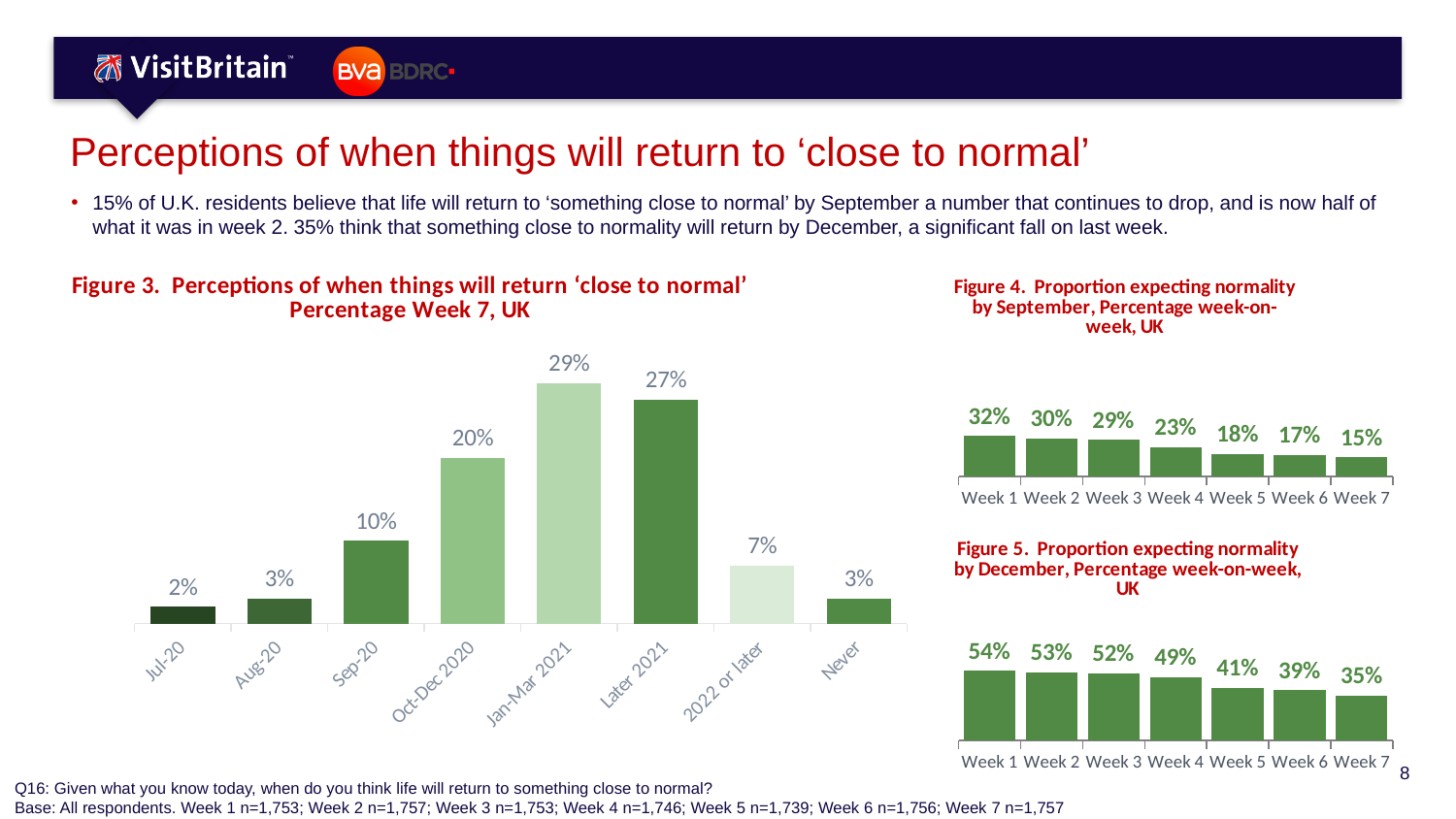
In Figure 3, what is the value for 'Never'? 3% In Figure 4, what is the value for Week 7? 15% In Figure 3, what percentage of respondents expect things to return close to normal in Jan-Mar 2021? 29% In Figure 5, what is the value for Week 4? 49% In Figure 3, what is the difference between the values for Oct-Dec 2020 and Sep-20? 10% In Figure 3, how many categories are shown on the x axis? 8 In Figure 3, which category has the lowest value? Jul-20 In Figure 3, which category has the highest value? Jan-Mar 2021 What kind of chart is Figure 3? Bar chart In Figure 4, what is the difference between Week 1 and Week 7? 17% In Figure 5, which is larger, the value for Week 5 or the value for Week 7? Week 5 In Figure 4, do the values rise or fall from Week 1 to Week 7? Fall